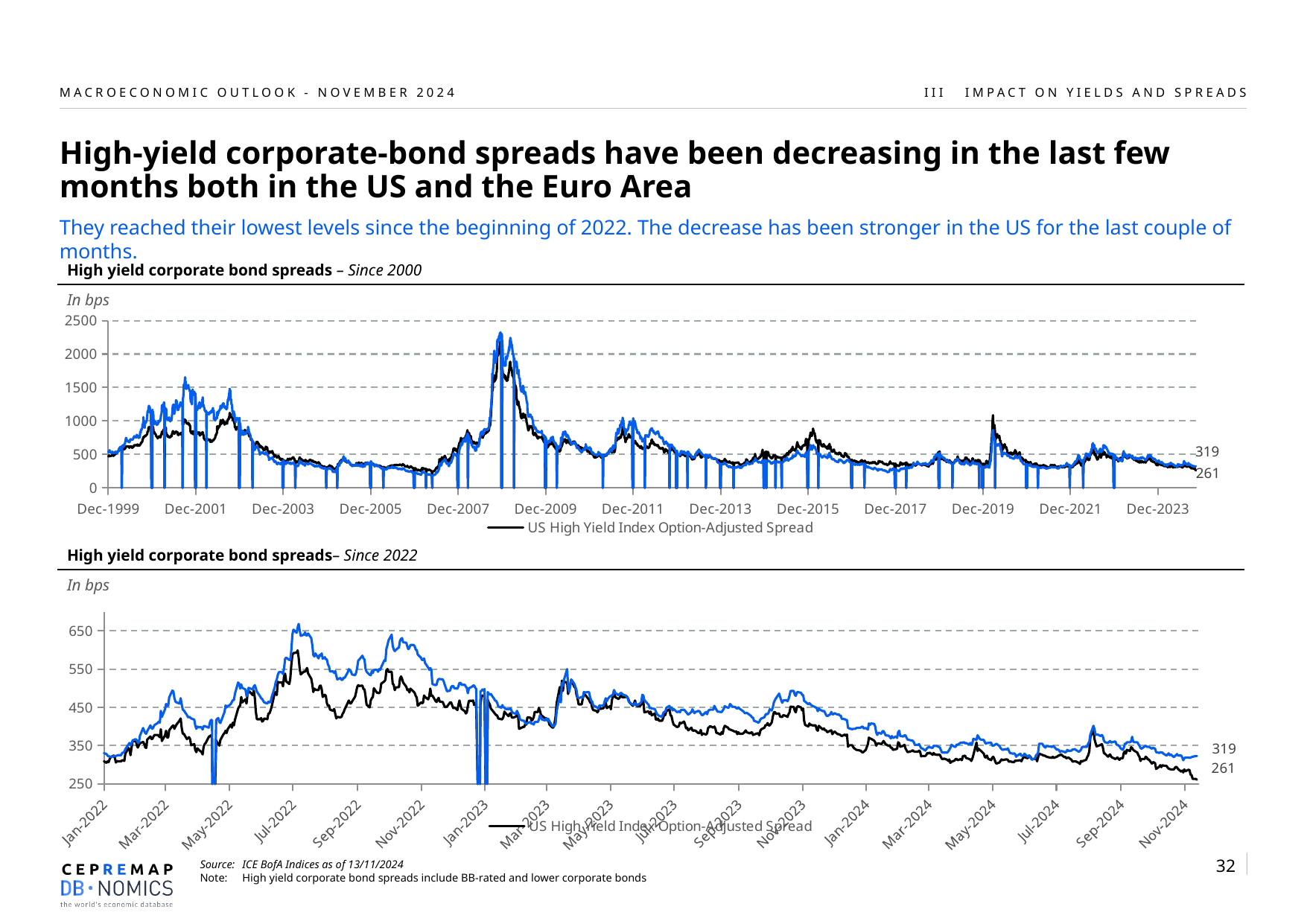
In the bottom chart, 'Since 2022', which of the two end values labelled on the right is larger, 319 or 261? 319 In the top chart, 'Since 2000', what two values are labelled at the right end of the lines? 319 and 261 In the bottom chart, 'Since 2022', is the peak value reached around Jul-2022 greater or less than 550? greater In what unit are the values of both charts expressed, according to the label above the y axis? In bps In the bottom chart, 'Since 2022', do the spreads rise or fall overall from Jul-2022 to Nov-2024? Fall What kind of chart is the top chart, 'High yield corporate bond spreads – Since 2000'? Line chart How many date labels are shown on the x axis of the bottom chart, 'Since 2022'? 18 In the bottom chart, 'Since 2022', what is the difference between the two values labelled at the right end of the lines, 319 and 261? 58 How many series does the legend of the top chart, 'Since 2000', list? 1 In the top chart, 'Since 2000', is the highest peak of the spreads (around 2008) greater or less than 2000? greater In the bottom chart, 'Since 2022', is the US High Yield Index Option-Adjusted Spread at Nov-2024 greater or less than 350? less In the bottom chart, 'High yield corporate bond spreads – Since 2022', what is the latest value labelled for the US High Yield Index Option-Adjusted Spread (black line)? 261